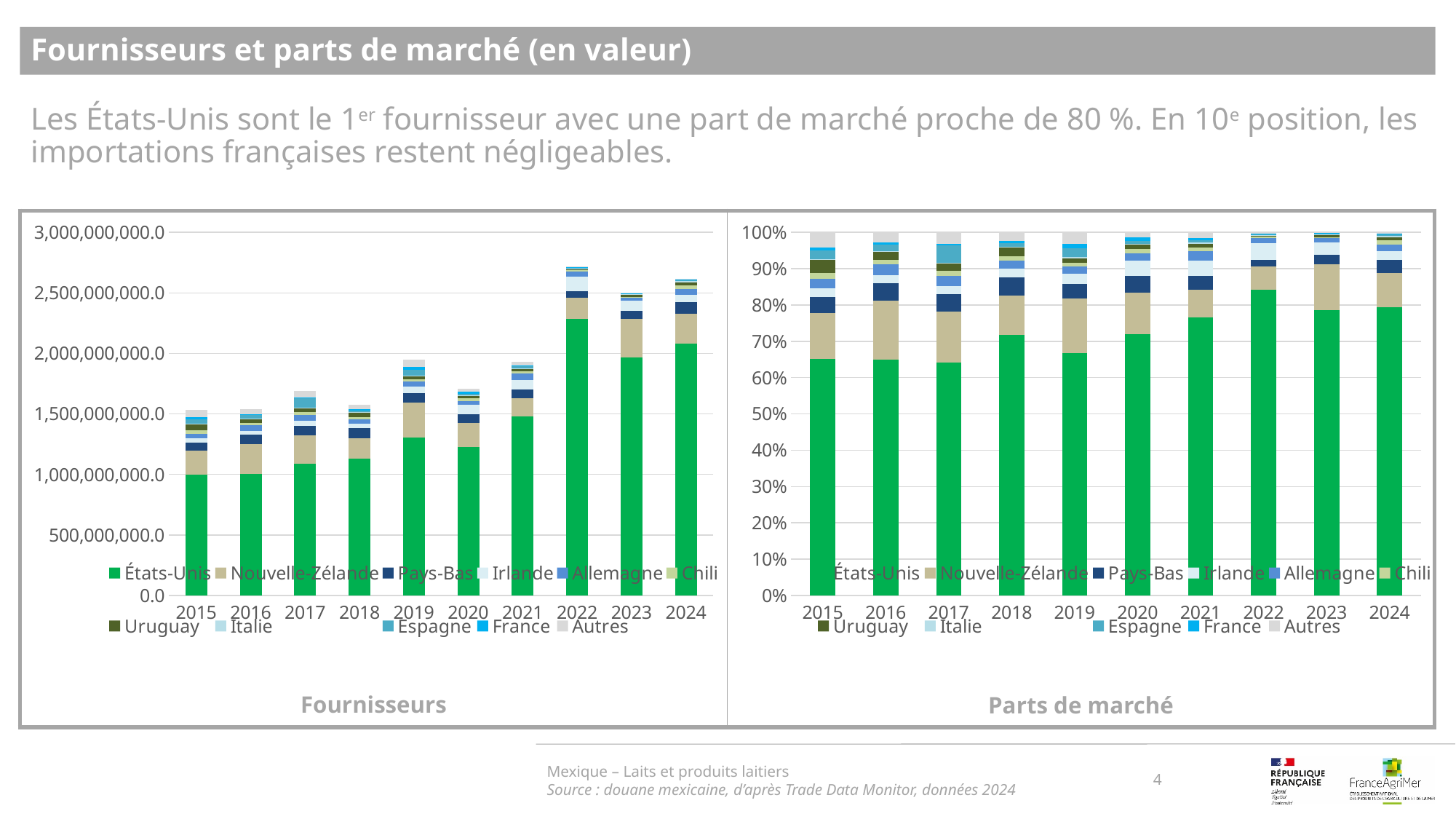
In the 'Fournisseurs' chart, is the total for 2018 greater or less than 2,000,000,000.0? less How many years are shown on the x axis of the 'Parts de marché' chart? 10 In the 'Parts de marché' chart, is the share of États-Unis in 2015 greater or less than 70%? less How many series does the legend of the 'Fournisseurs' chart list? 11 What colour represents États-Unis in the legend of both charts? green What kind of chart is the 'Fournisseurs' chart on the left? stacked bar chart In the 'Fournisseurs' chart, which year has the tallest stacked bar? 2022 In the 'Fournisseurs' chart, is the total for 2022 greater or less than 2,500,000,000.0? greater In the 'Parts de marché' chart, which year shows the highest share for États-Unis? 2022 In the 'Fournisseurs' chart, do the total import values generally rise or fall from 2015 to 2024? rise In the 'Fournisseurs' chart, which total is larger, 2022 or 2024? 2022